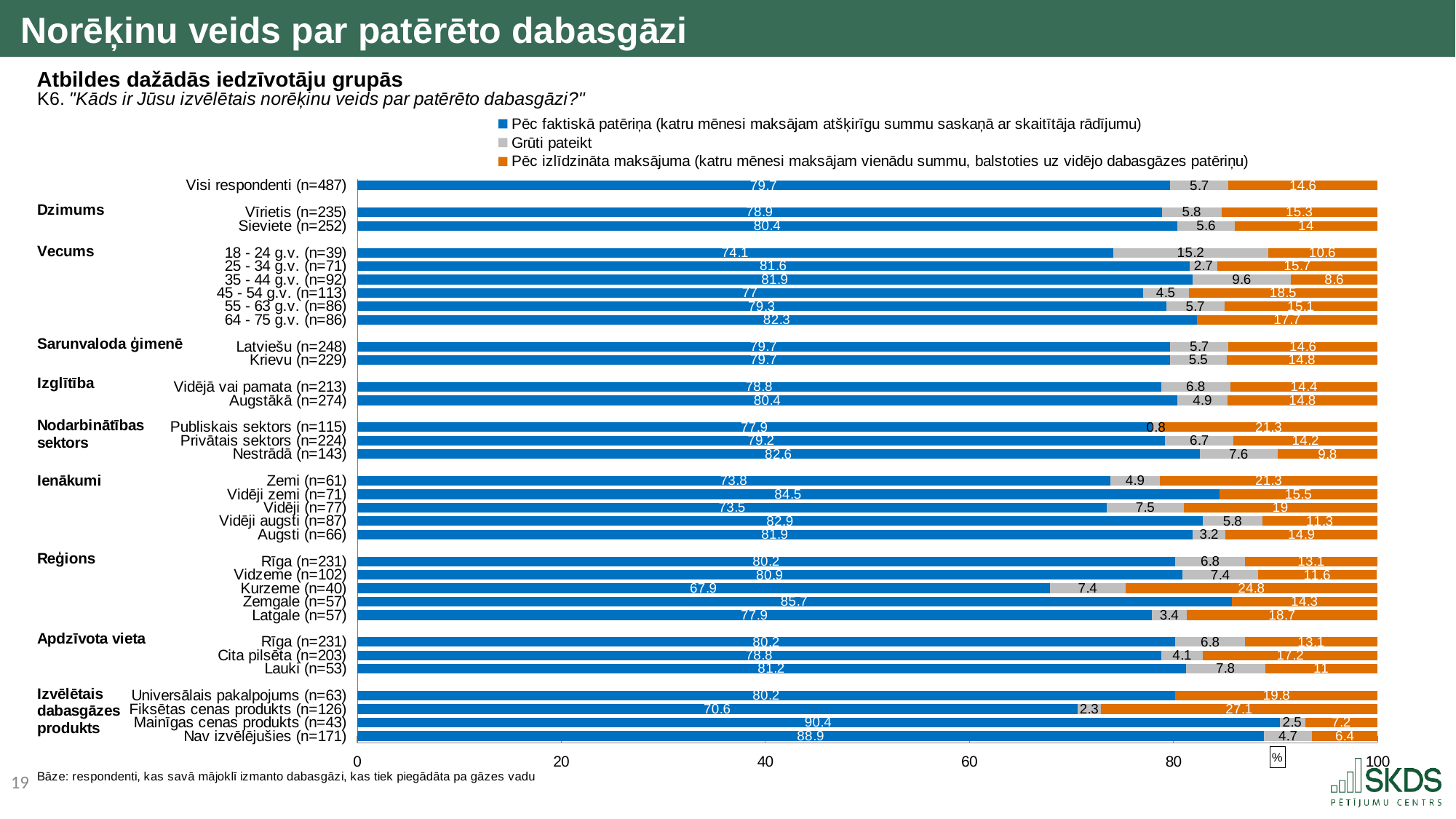
What is the value of "Grūti pateikt" for Publiskais sektors (n=115)? 0.8 What is the total of the stacked bar for Visi respondenti (n=487)? 100 Which group has the highest value for "Pēc izlīdzināta maksājuma"? Fiksētas cenas produkts (n=126) What is the value of "Grūti pateikt" for 18 - 24 g.v. (n=39)? 15.2 What is the value of "Pēc izlīdzināta maksājuma" for Kurzeme (n=40)? 24.8 Which has a larger "Pēc faktiskā patēriņa" value, Vīrietis (n=235) or Sieviete (n=252)? Sieviete (n=252) What kind of chart is shown on the slide? Stacked bar chart How many series does the legend list? 3 Which group has the lowest value for "Pēc faktiskā patēriņa"? Kurzeme (n=40) What is the value of "Pēc faktiskā patēriņa" for Visi respondenti (n=487)? 79.7 Which group has the highest value for "Pēc faktiskā patēriņa"? Mainīgas cenas produkts (n=43) What is the difference between the "Pēc izlīdzināta maksājuma" values for Kurzeme (n=40) and Rīga (n=231)? 11.7